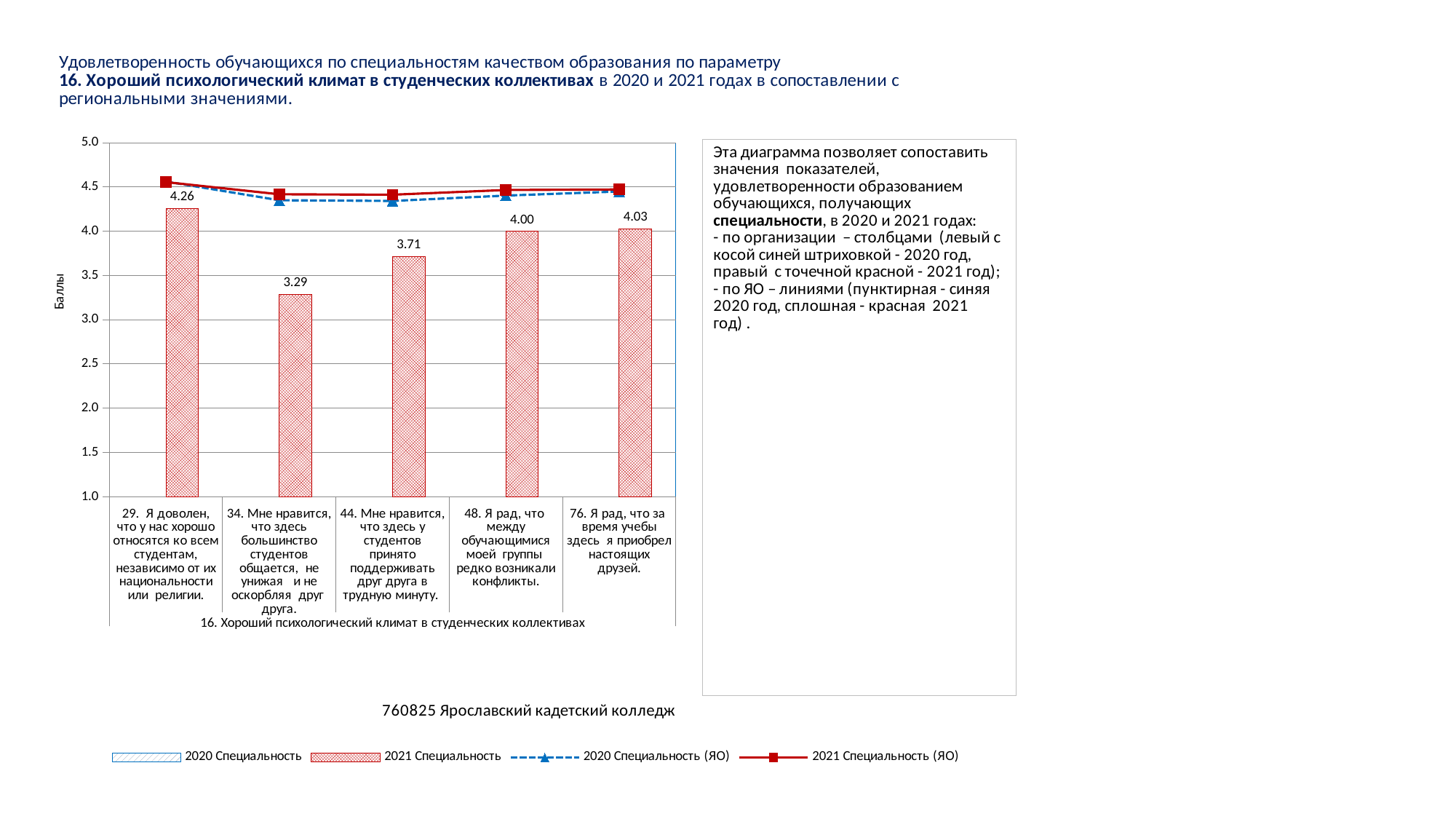
Is the 2021 Специальность (ЯО) value for item 34 greater or less than 4.0? greater How many items (categories) are shown on the x axis? 5 What is the 2021 Специальность value for item 34 (Мне нравится, что здесь большинство студентов общается, не унижая и не оскорбляя друг друга)? 3.29 Which is larger for 2021 Специальность: item 44 or item 48? 48. Я рад, что между обучающимися моей группы редко возникали конфликты. What is the 2021 Специальность value for item 44 (Мне нравится, что здесь у студентов принято поддерживать друг друга в трудную минуту)? 3.71 What is the 2021 Специальность value for item 76 (Я рад, что за время учебы здесь я приобрел настоящих друзей)? 4.03 What is the 2021 Специальность value for item 29 (Я доволен, что у нас хорошо относятся ко всем студентам...)? 4.26 Which item has the lowest 2021 Специальность bar? 34. Мне нравится, что здесь большинство студентов общается, не унижая и не оскорбляя друг друга. What is the difference between the 2021 Специальность values for item 29 and item 34? 0.97 What is the label of the y axis? Баллы Which item has the highest 2021 Специальность bar? 29. Я доволен, что у нас хорошо относятся ко всем студентам, независимо от их национальности или религии. How many series does the legend list? 4